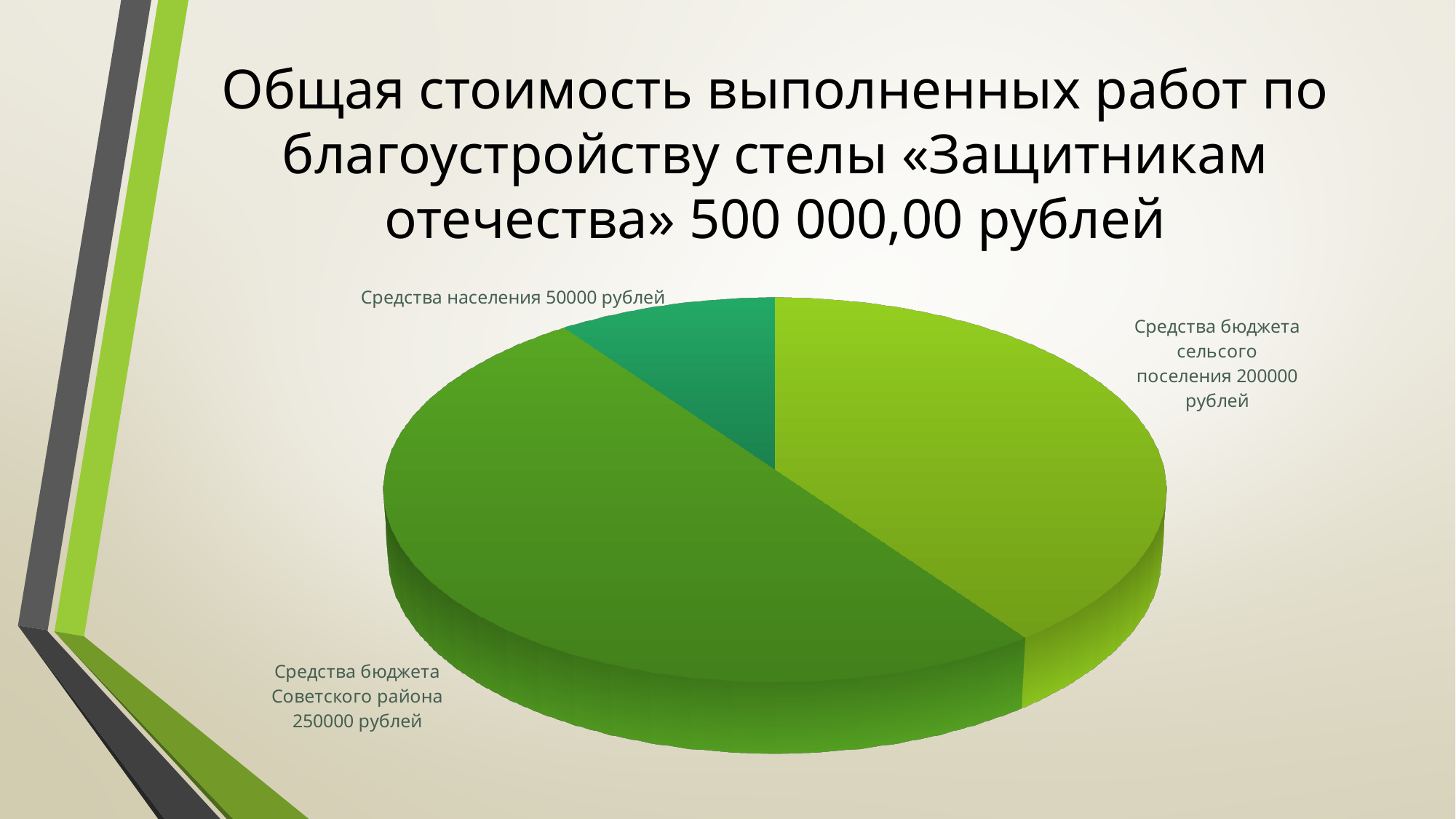
What share of the pie does Средства бюджета Советского района represent? 50% What share of the pie does Средства населения represent? 10% What is the value for Средства населения? 50000 рублей What kind of chart is shown on the slide? Pie chart What is the value for Средства бюджета сельсого поселения? 200000 рублей What is the value for Средства бюджета Советского района? 250000 рублей Which is larger: Средства бюджета сельсого поселения or Средства населения? Средства бюджета сельсого поселения How many slices does the pie chart have? 3 Which slice of the pie chart is the smallest? Средства населения What total amount is stated in the slide title? 500 000,00 рублей What is the difference between Средства бюджета Советского района and Средства бюджета сельсого поселения? 50000 рублей Which slice of the pie chart is the largest? Средства бюджета Советского района